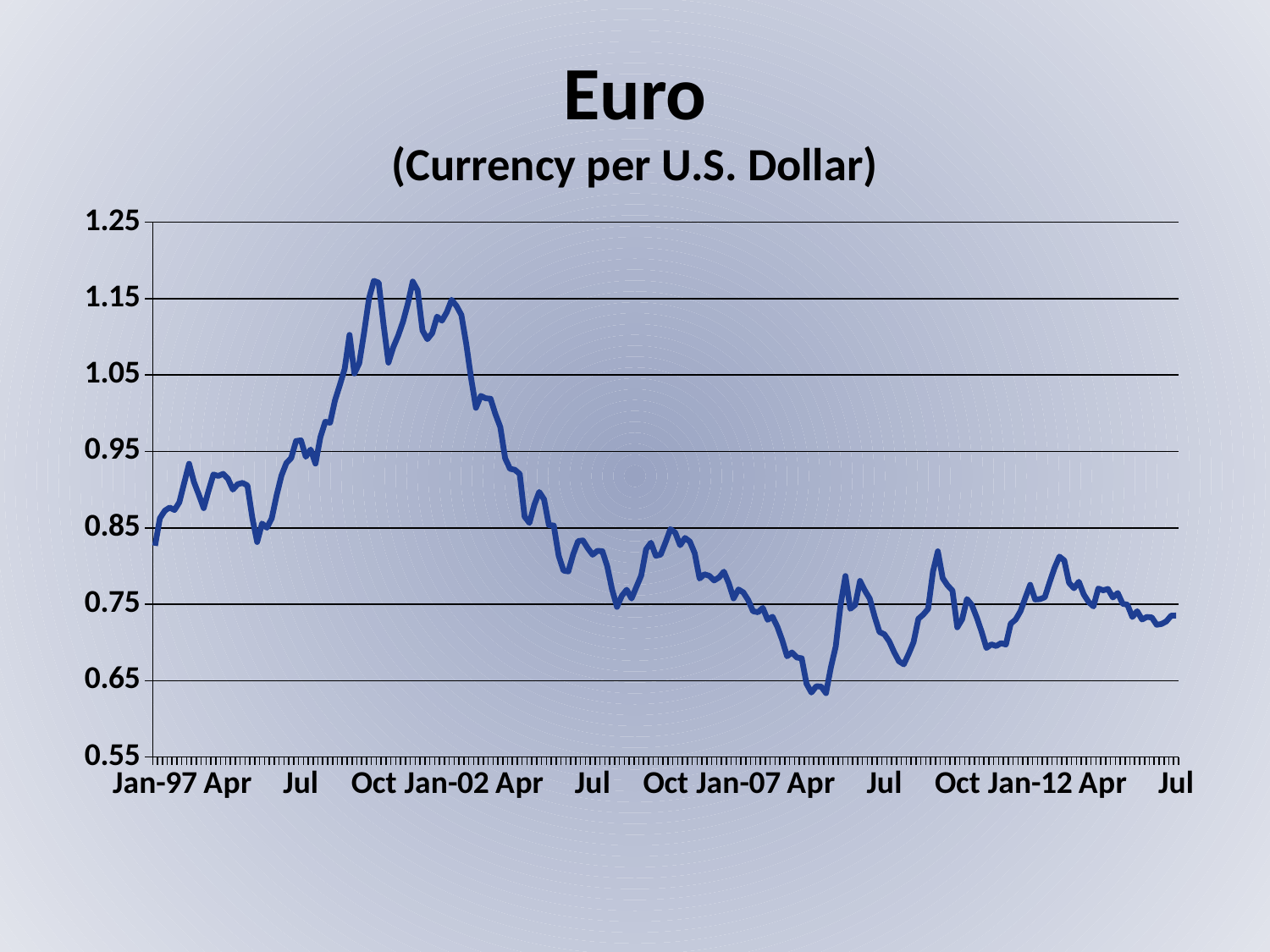
Is the value at Jan-02 greater or less than 1.05? greater Is the lowest value of the line greater or less than 0.65? less Is the value at Jan-97 greater or less than 0.75? greater Does the line generally rise or fall between Jan-02 and Jan-07? fall Which is larger, the value at Jan-02 or the value at Jan-12? Jan-02 What is the title of the chart? Euro (Currency per U.S. Dollar) What is the highest value shown on the vertical axis? 1.25 What kind of chart is shown on the slide? line chart Does the line generally rise or fall between Jan-97 and Jan-02? rise